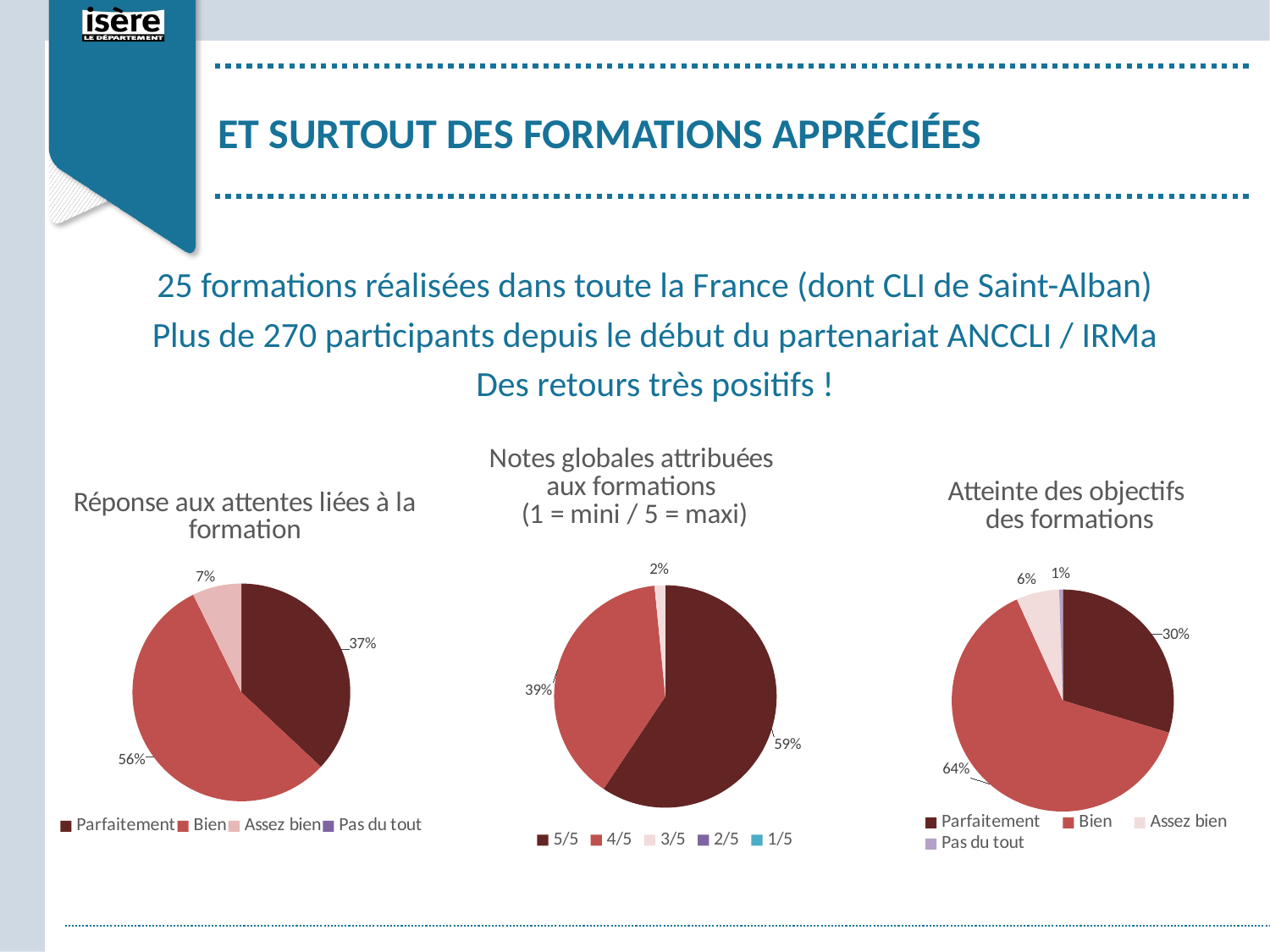
In the chart 'Atteinte des objectifs des formations', what share is labelled for 'Pas du tout'? 1% In the chart 'Réponse aux attentes liées à la formation', which category has the largest slice? Bien In the chart 'Notes globales attribuées aux formations', which is larger, the '5/5' slice or the '4/5' slice? 5/5 What type of chart is used for 'Atteinte des objectifs des formations'? Pie chart In the chart 'Réponse aux attentes liées à la formation', what is the difference between the 'Bien' and 'Parfaitement' shares? 19% In the chart 'Notes globales attribuées aux formations', how many entries does the legend list? 5 In the chart 'Notes globales attribuées aux formations', what share is labelled for '3/5'? 2% In the chart 'Réponse aux attentes liées à la formation', what share is labelled for 'Parfaitement'? 37% In the chart 'Notes globales attribuées aux formations', what share is labelled for '5/5'? 59% In the chart 'Atteinte des objectifs des formations', which category has the smallest labelled slice? Pas du tout In the chart 'Atteinte des objectifs des formations', what share is labelled for 'Bien'? 64% In the chart 'Réponse aux attentes liées à la formation', what share is labelled for 'Bien'? 56%